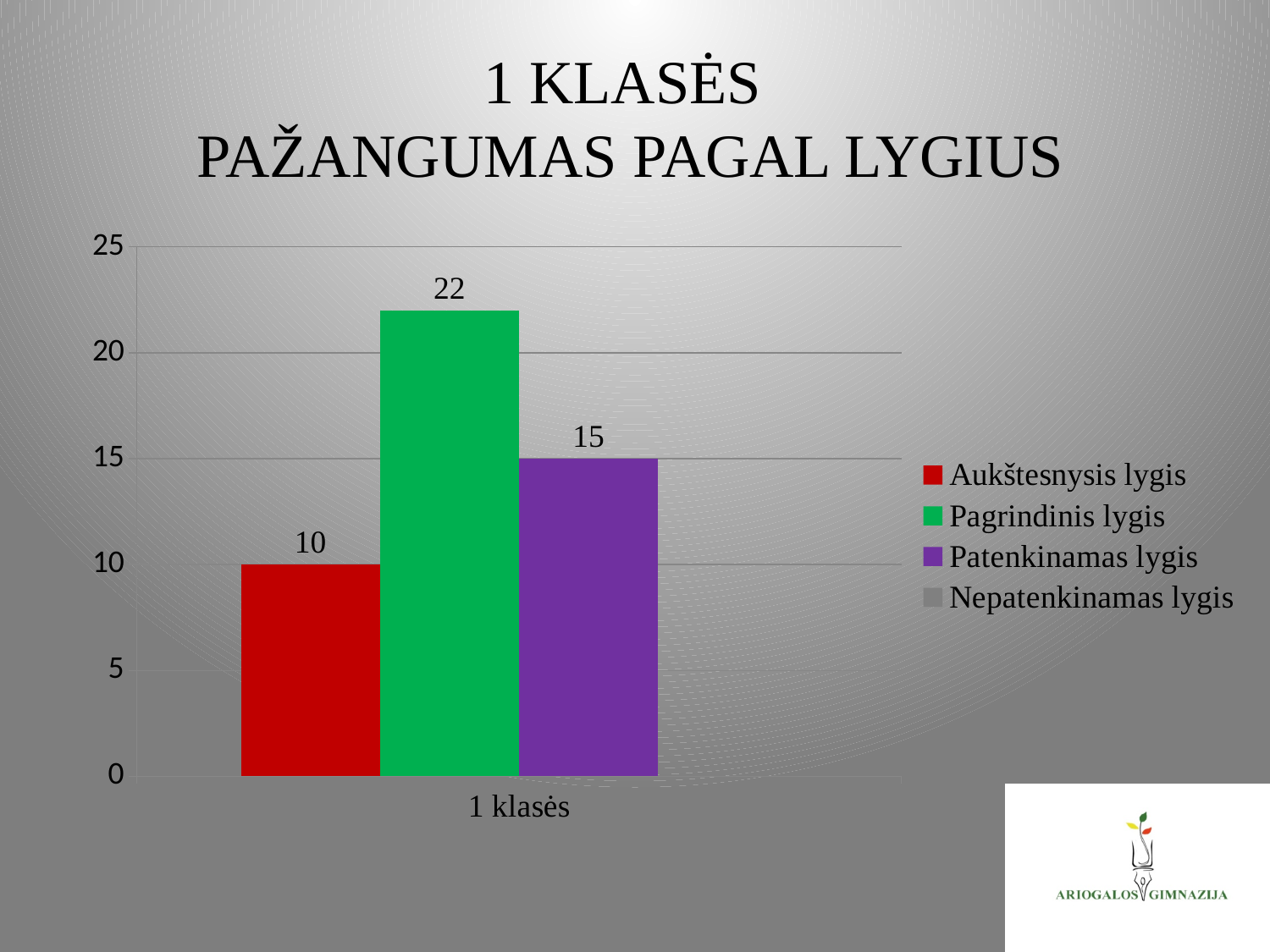
What is the value for Patenkinamas lygis? 15 What kind of chart is shown on the slide? bar chart What is the difference between the values for Patenkinamas lygis and Aukštesnysis lygis? 5 What is the category label on the x axis? 1 klasės What is the value for Aukštesnysis lygis? 10 What is the difference between the values for Pagrindinis lygis and Patenkinamas lygis? 7 How many series does the legend list? 4 What is the value for Pagrindinis lygis? 22 Which series has the highest value? Pagrindinis lygis Which is larger, the value for Aukštesnysis lygis or the value for Patenkinamas lygis? Patenkinamas lygis Which of the plotted series has the lowest value? Aukštesnysis lygis Is the value for Pagrindinis lygis greater or less than 20? greater